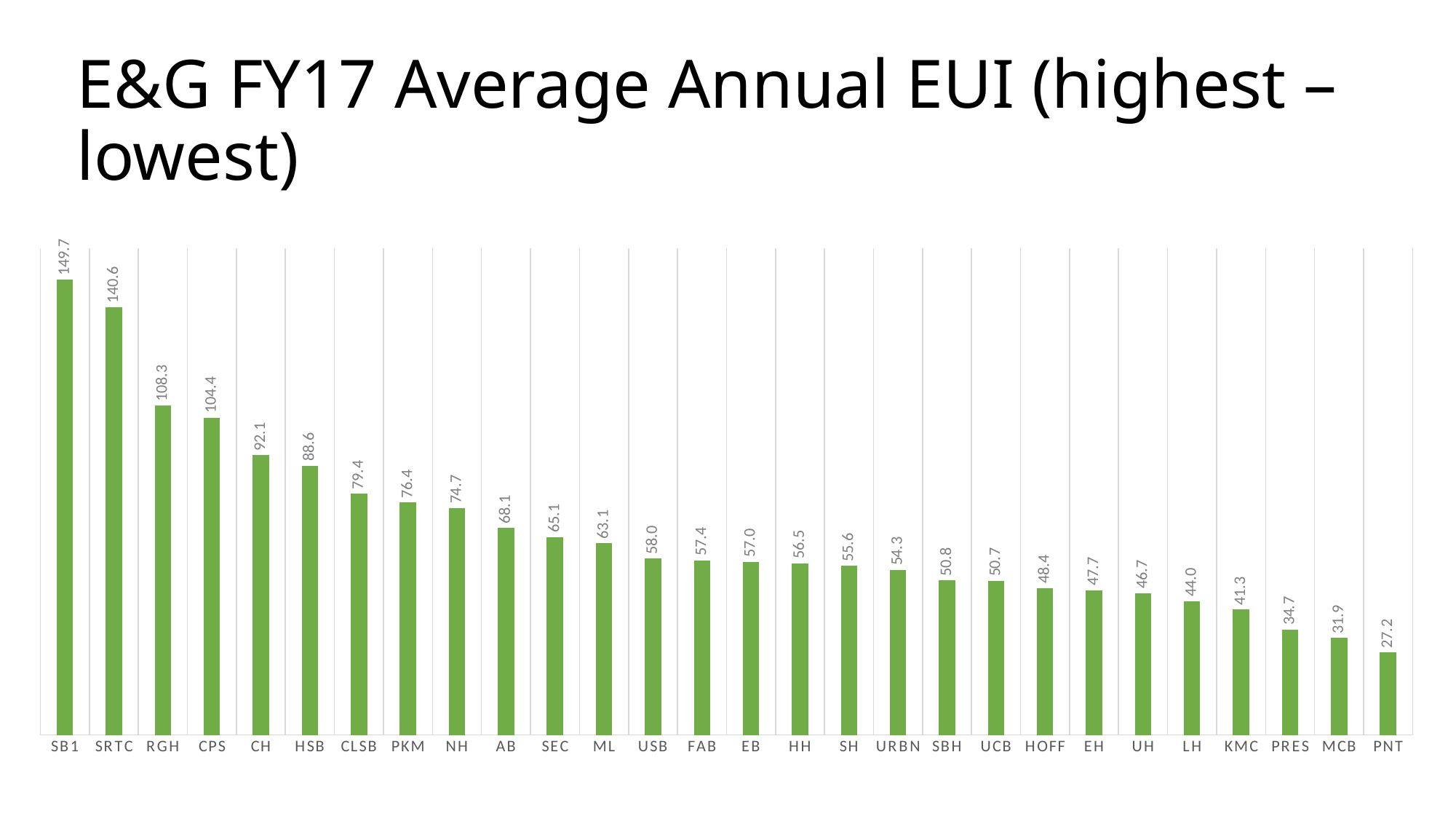
Which category has the highest value? SB1 What is the value for SB1? 149.7 Do the values rise or fall from left to right along the x axis? Fall Which is larger, the value for CH or the value for HSB? CH How many categories are shown on the x axis? 28 Which category has the lowest value? PNT What is the value for CLSB? 79.4 What is the value for PRES? 34.7 What is the difference between the values for RGH and CPS? 3.9 What kind of chart is shown on the slide? Bar chart What is the value for URBN? 54.3 What is the difference between the values for SB1 and SRTC? 9.1